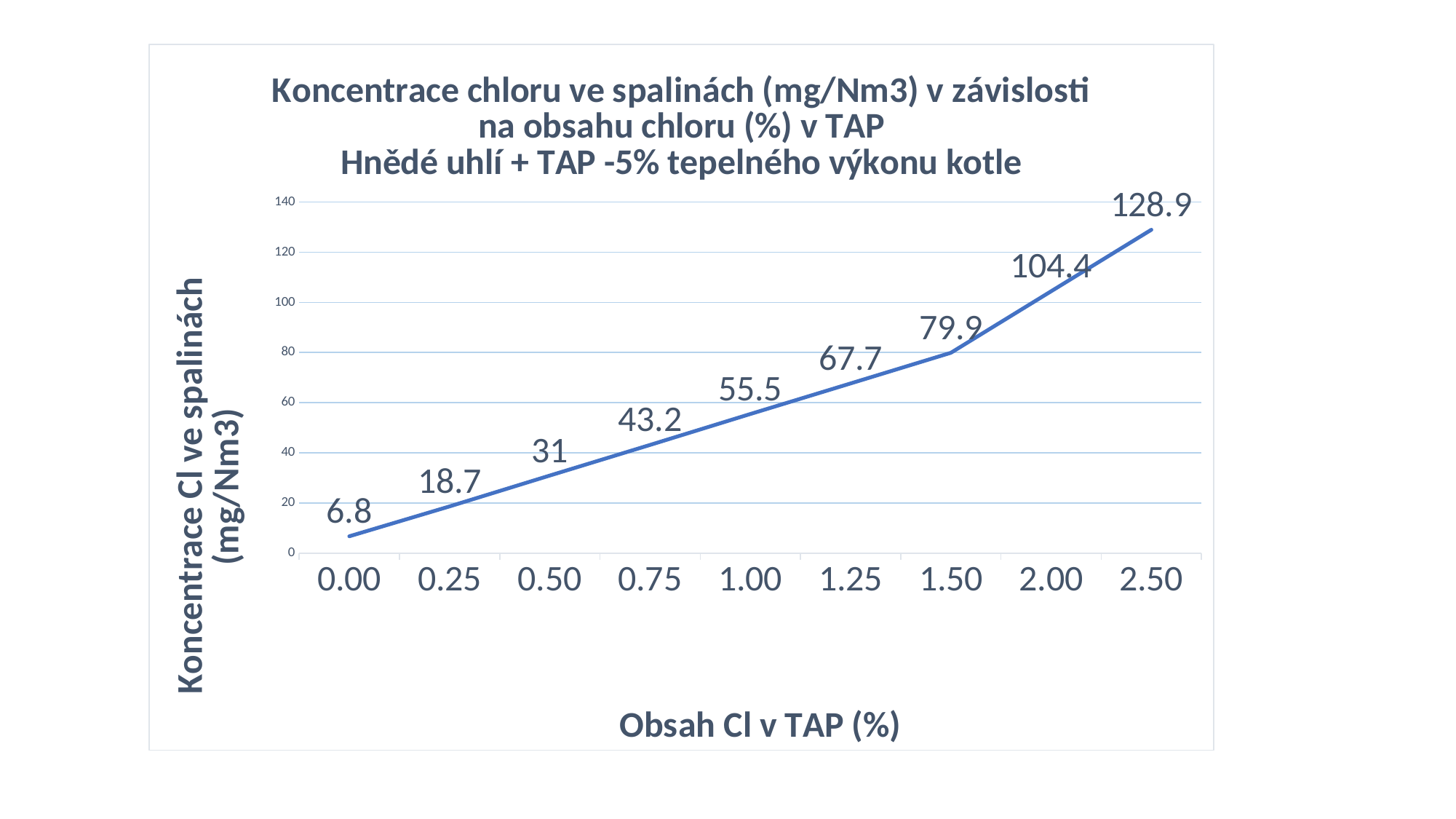
What is the Cl concentration in flue gas at a Cl content of 0.00% in TAP? 6.8 At which Cl content in TAP is the flue gas Cl concentration lowest? 0.00 At which Cl content in TAP is the flue gas Cl concentration highest? 2.50 Which is larger: the Cl concentration at 0.75% or at 1.25% Cl content in TAP? 1.25 Is the Cl concentration at 1.50% Cl content in TAP greater or less than 100? less What is the difference between the Cl concentration at 2.50% and at 2.00% Cl content in TAP? 24.5 Do the values rise or fall as the Cl content in TAP increases along the x axis? rise What is the difference between the Cl concentration at 0.50% and at 0.25% Cl content in TAP? 12.3 What kind of chart is shown on the slide? line chart How many data points are plotted on the chart? 9 What is the Cl concentration in flue gas at a Cl content of 2.00% in TAP? 104.4 What is the Cl concentration in flue gas when the Cl content in TAP is 1.00%? 55.5